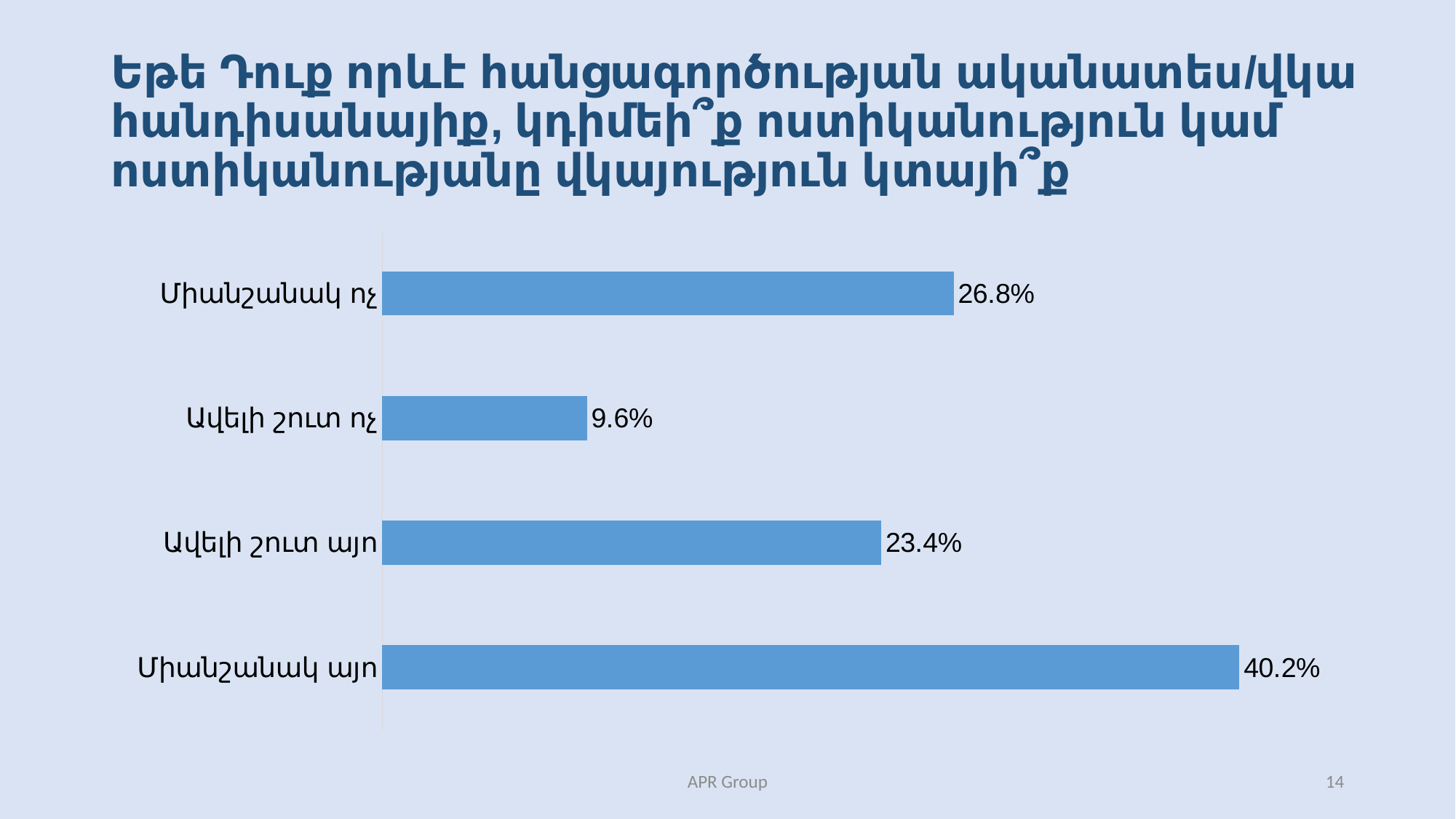
What colour are the bars in the chart? Blue What is the difference between the values for Միանշանակ այո and Միանշանակ ոչ? 13.4% What is the value for Միանշանակ այո? 40.2% Which is larger, the value for Միանշանակ ոչ or the value for Ավելի շուտ այո? Միանշանակ ոչ Which category has the highest value? Միանշանակ այո How many categories are shown in the chart? 4 What is the difference between the values for Ավելի շուտ այո and Ավելի շուտ ոչ? 13.8% What kind of chart is shown on the slide? Bar chart What is the value for Ավելի շուտ ոչ? 9.6% What is the value for Միանշանակ ոչ? 26.8% Which category has the lowest value? Ավելի շուտ ոչ What is the value for Ավելի շուտ այո? 23.4%